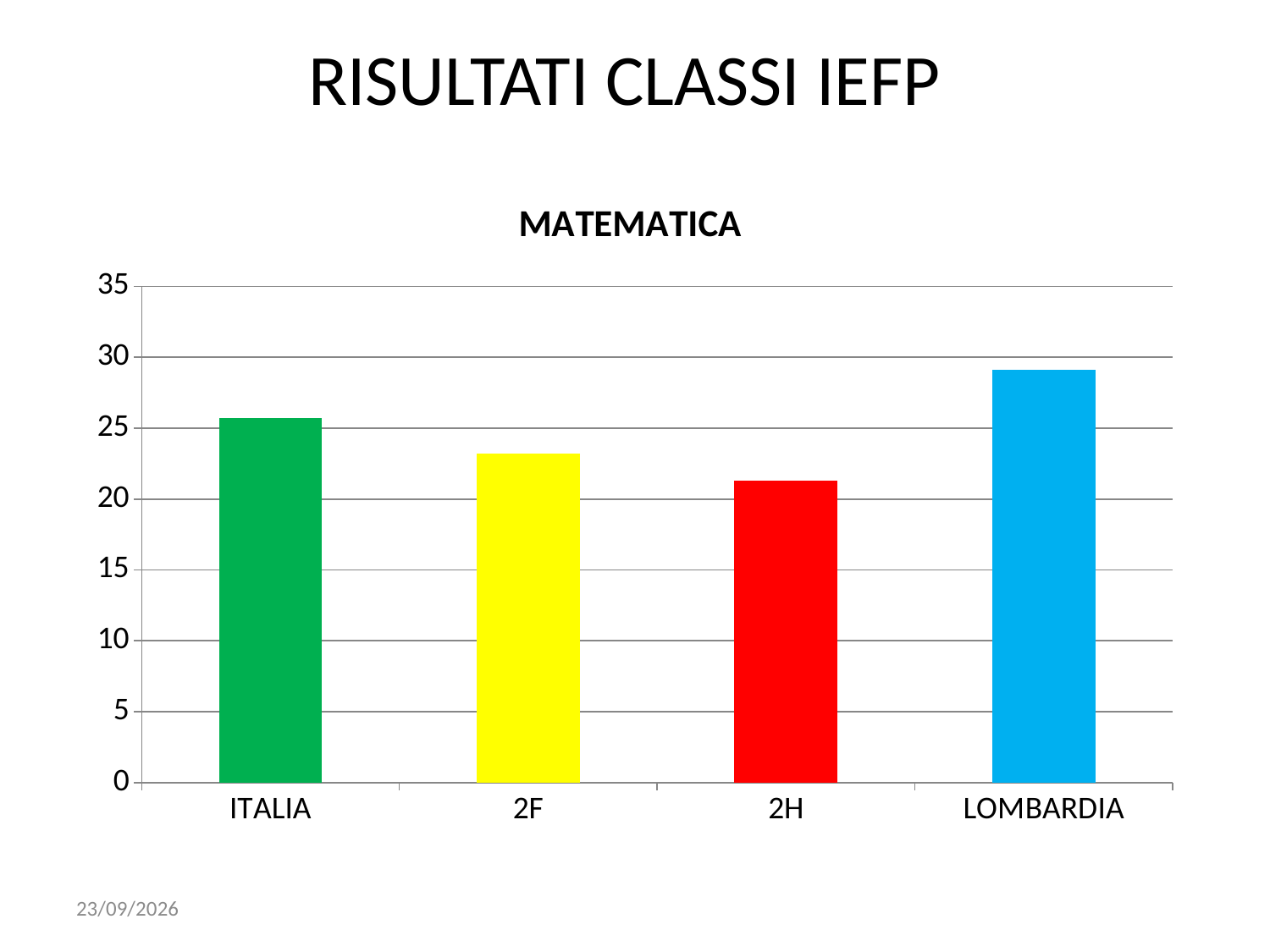
What is the title of the chart? MATEMATICA What colour is the bar for LOMBARDIA? light blue Which category has the highest value in the chart? LOMBARDIA Which is larger, the value for ITALIA or the value for 2F? ITALIA How many categories are shown on the x axis of the chart? 4 Is the value for LOMBARDIA greater or less than 25? greater Is the value for 2H greater or less than 25? less Is the value for 2F greater or less than 20? greater Which is larger, the value for 2F or the value for 2H? 2F Which category has the lowest value in the chart? 2H What kind of chart is shown on the slide? bar chart